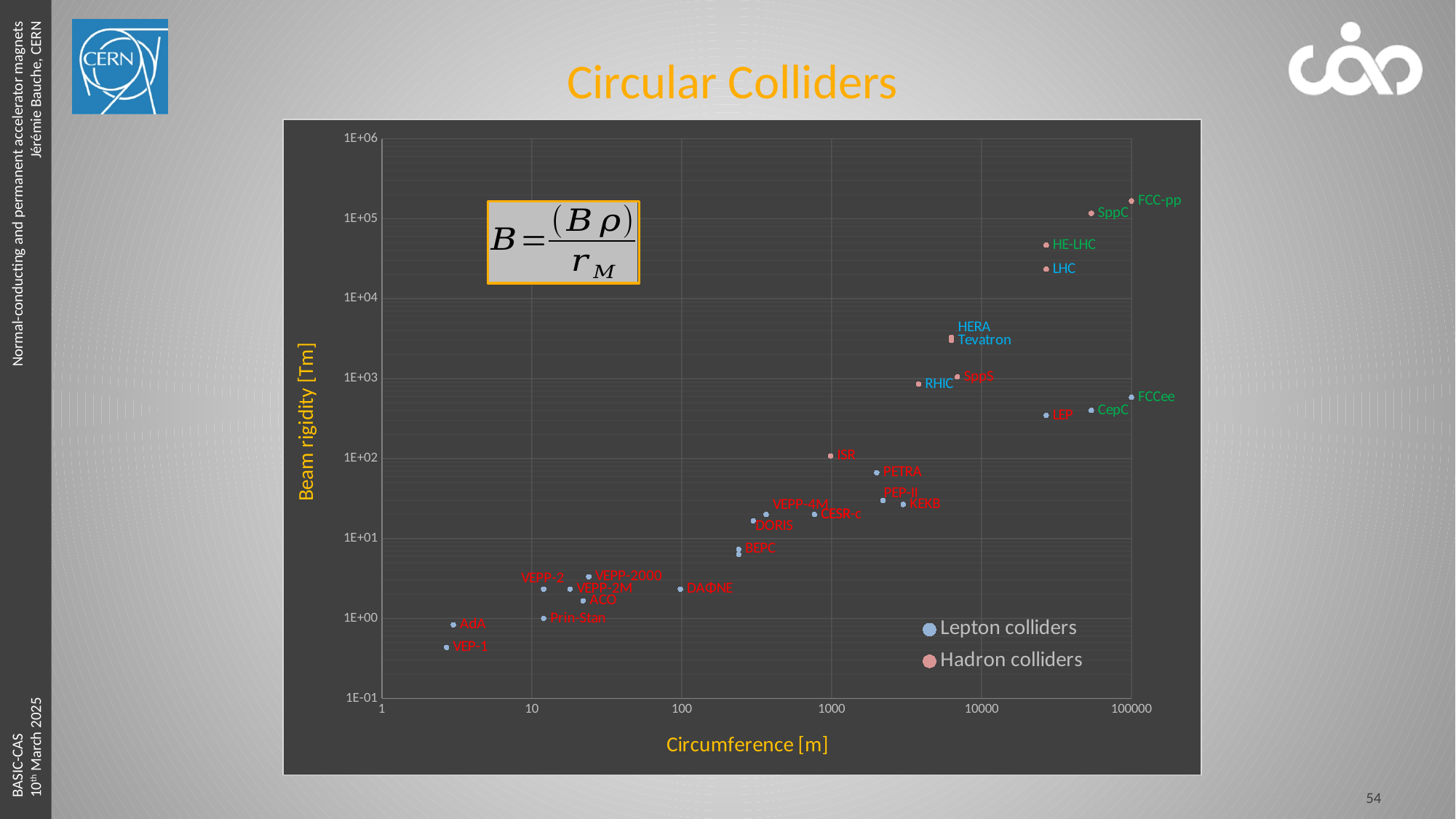
What kind of chart is shown on the slide? scatter chart Does beam rigidity generally rise or fall as circumference increases? rise Which collider has the lowest beam rigidity? VEP-1 Which has the larger beam rigidity, HERA or RHIC? HERA Is the beam rigidity for FCC-pp greater or less than 1E+05 Tm? greater Is the beam rigidity for LEP greater or less than 1E+03 Tm? less Is the circumference for BEPC greater or less than 100 m? greater What is the label of the x axis? Circumference [m] How many series does the legend list? 2 Which collider has the highest beam rigidity? FCC-pp Which has the larger beam rigidity, LHC or LEP? LHC